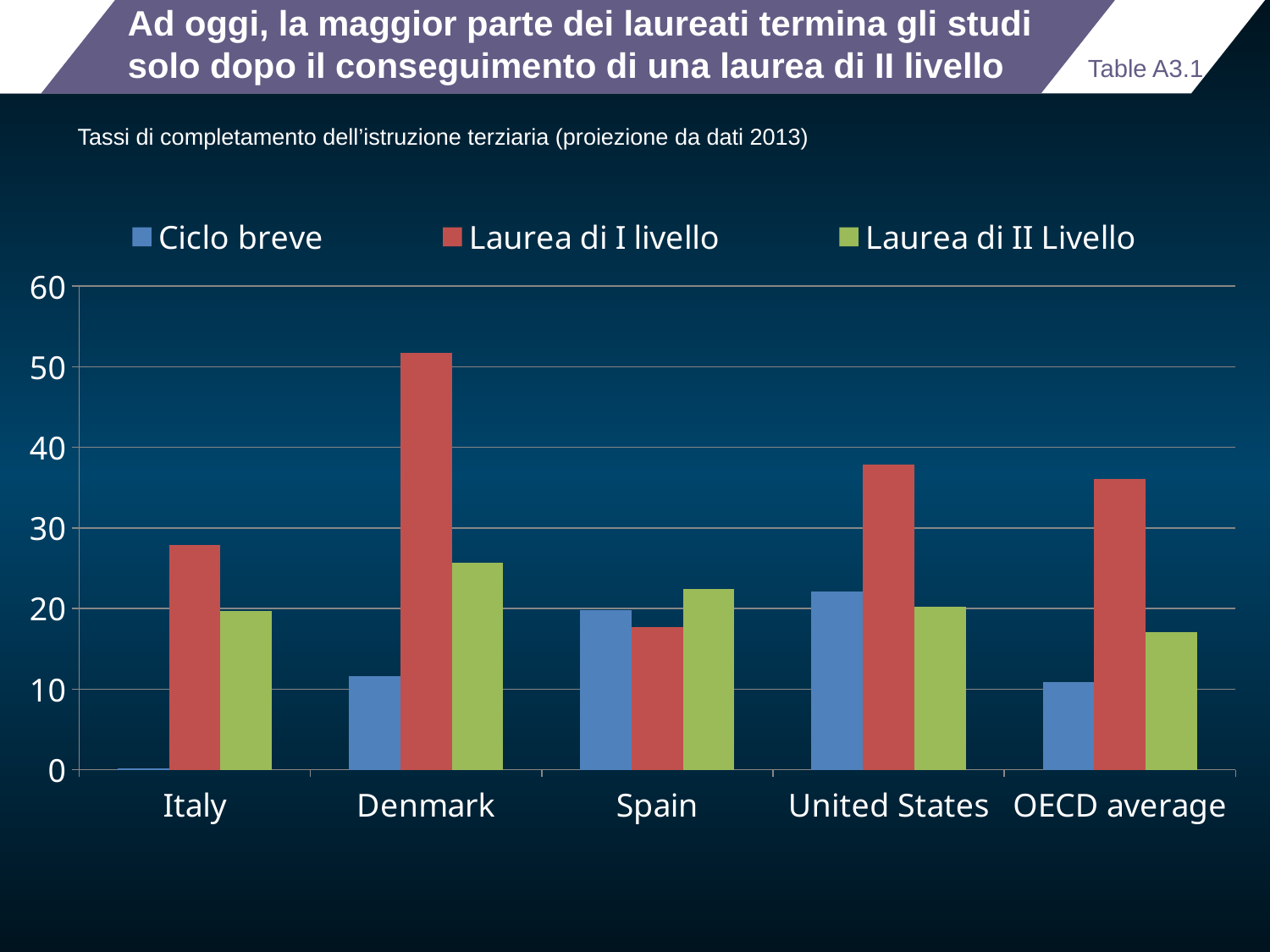
Is the value for Laurea di I livello in Denmark greater or less than 50? greater What kind of chart is shown on the slide? bar chart Which is larger: Laurea di II Livello in Denmark or Laurea di II Livello in Italy? Denmark Is the value for Ciclo breve in OECD average greater or less than 20? less Is the value for Laurea di I livello in Italy greater or less than 30? less What colour represents Laurea di II Livello in the legend? green In Spain, which is larger: Ciclo breve or Laurea di I livello? Ciclo breve Which category has the lowest value for Ciclo breve? Italy Which category has the highest value for Laurea di I livello? Denmark How many series does the legend list? 3 How many countries or categories are shown on the x axis? 5 Which category has the highest value for Laurea di II Livello? Denmark